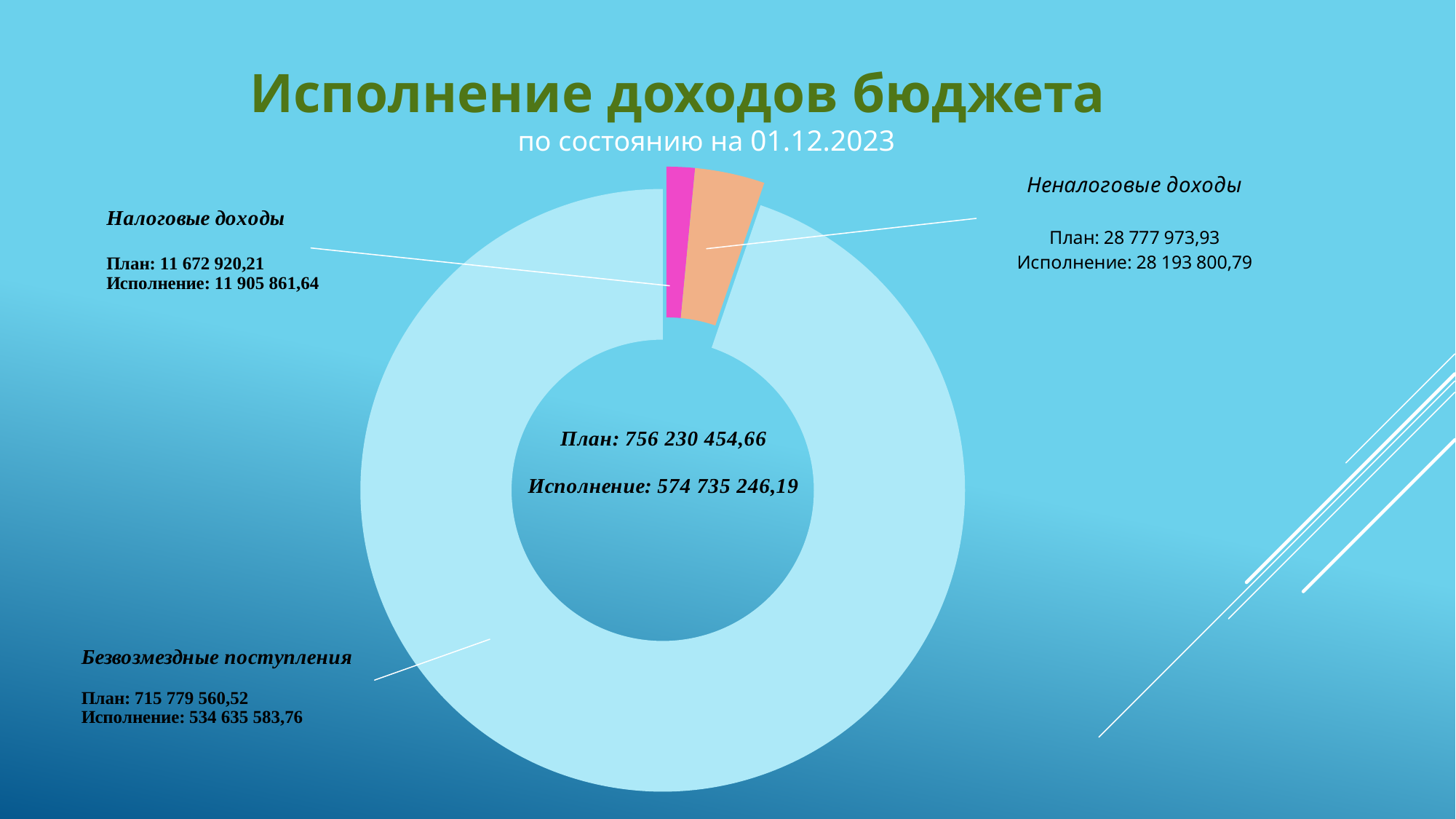
Which category has the smallest share of the doughnut chart? Налоговые доходы Which is larger, the Исполнение for Налоговые доходы or the Исполнение for Неналоговые доходы? Неналоговые доходы What is the total План across all three categories? 756 230 454,66 How many categories does the doughnut chart show? 3 What is the difference between План and Исполнение for Безвозмездные поступления? 181 143 976,76 What is the total Исполнение value shown in the centre of the chart? 574 735 246,19 What is the План value for Безвозмездные поступления? 715 779 560,52 What colour is the Налоговые доходы segment of the chart? Pink What is the Исполнение value for Неналоговые доходы? 28 193 800,79 What kind of chart is shown on the slide? Doughnut (pie) chart What is the План value for Налоговые доходы? 11 672 920,21 Which category has the largest share of the doughnut chart? Безвозмездные поступления